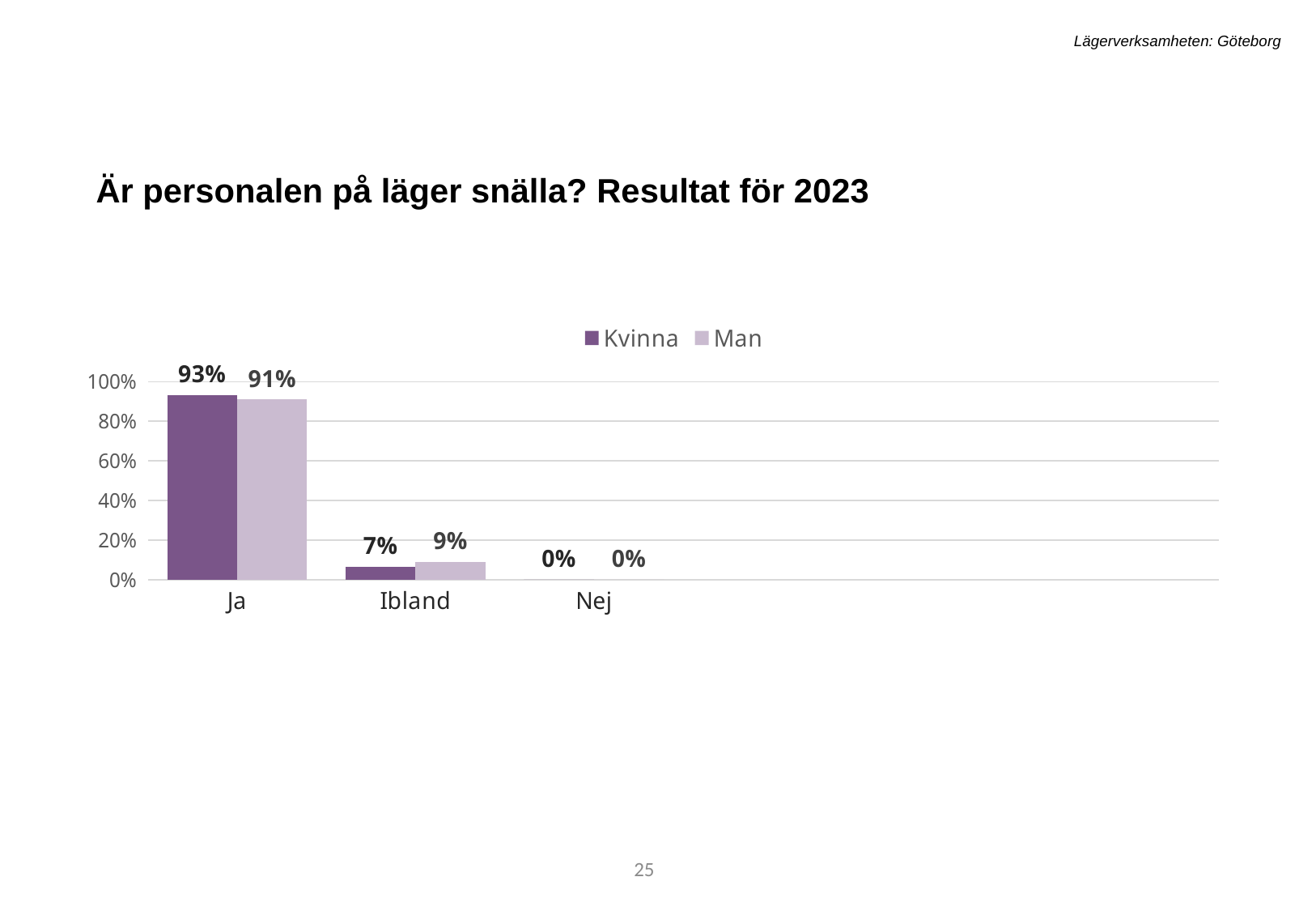
What is the value for Kvinna in the Ibland category? 7% Which category has the lowest value for Man? Nej In the Ibland category, which series has the larger value, Kvinna or Man? Man What is the value for Man in the Ja category? 91% What is the value for Man in the Ibland category? 9% How many series does the legend list? 2 What is the difference between the Kvinna and Man values in the Ja category? 2% How many categories are shown on the x axis? 3 Which category has the highest value for Kvinna? Ja What is the value for Kvinna in the Ja category? 93% What is the value for Man in the Nej category? 0% What kind of chart is shown on the slide? Bar chart